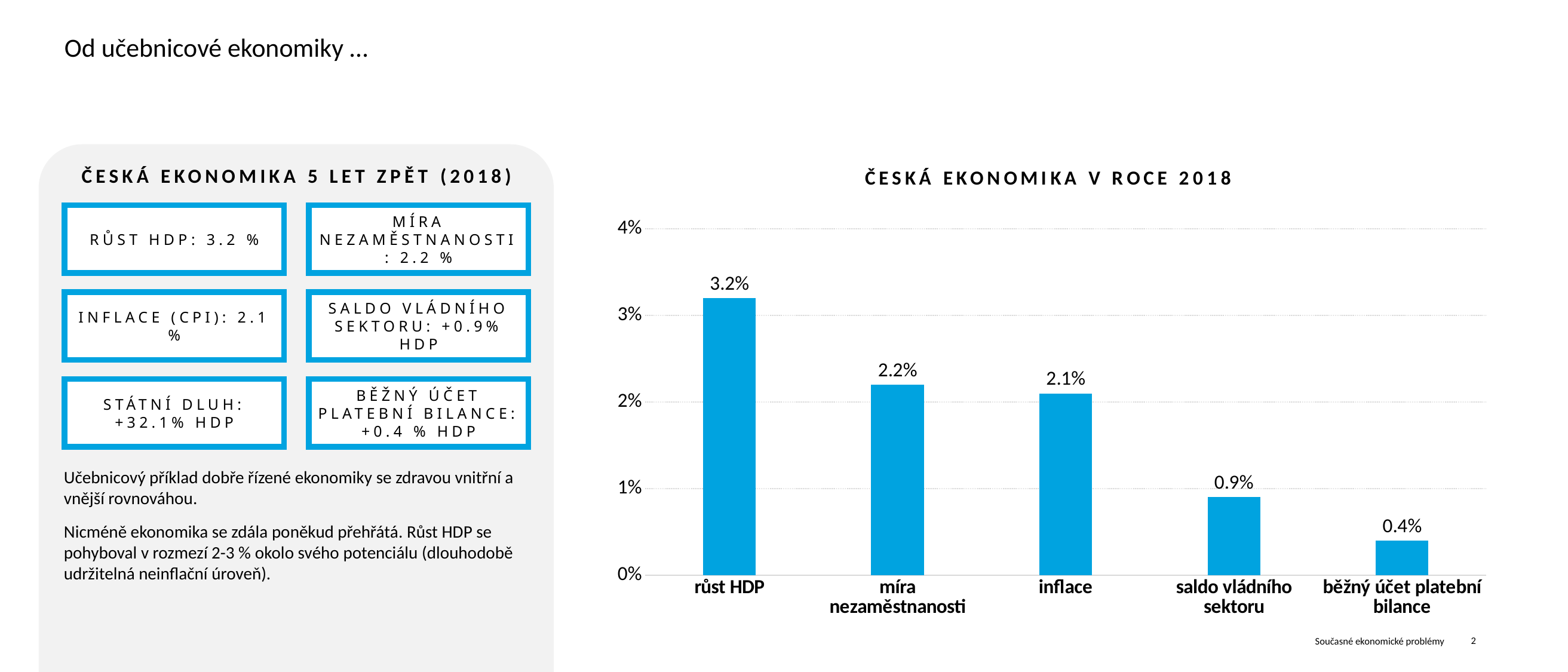
What is the title of the chart? ČESKÁ EKONOMIKA V ROCE 2018 Which category has the highest value in the chart? růst HDP What is the value for míra nezaměstnanosti in the chart? 2.2% How many categories are shown in the chart? 5 What is the value for saldo vládního sektoru in the chart? 0.9% What kind of chart is shown on the slide? bar chart What is the difference between the values for růst HDP and inflace? 1.1% Which category has the lowest value in the chart? běžný účet platební bilance Is the value for inflace greater or less than 1%? greater Which is larger, the value for míra nezaměstnanosti or the value for saldo vládního sektoru? míra nezaměstnanosti What is the value for běžný účet platební bilance in the chart? 0.4% What is the value for růst HDP in the chart? 3.2%